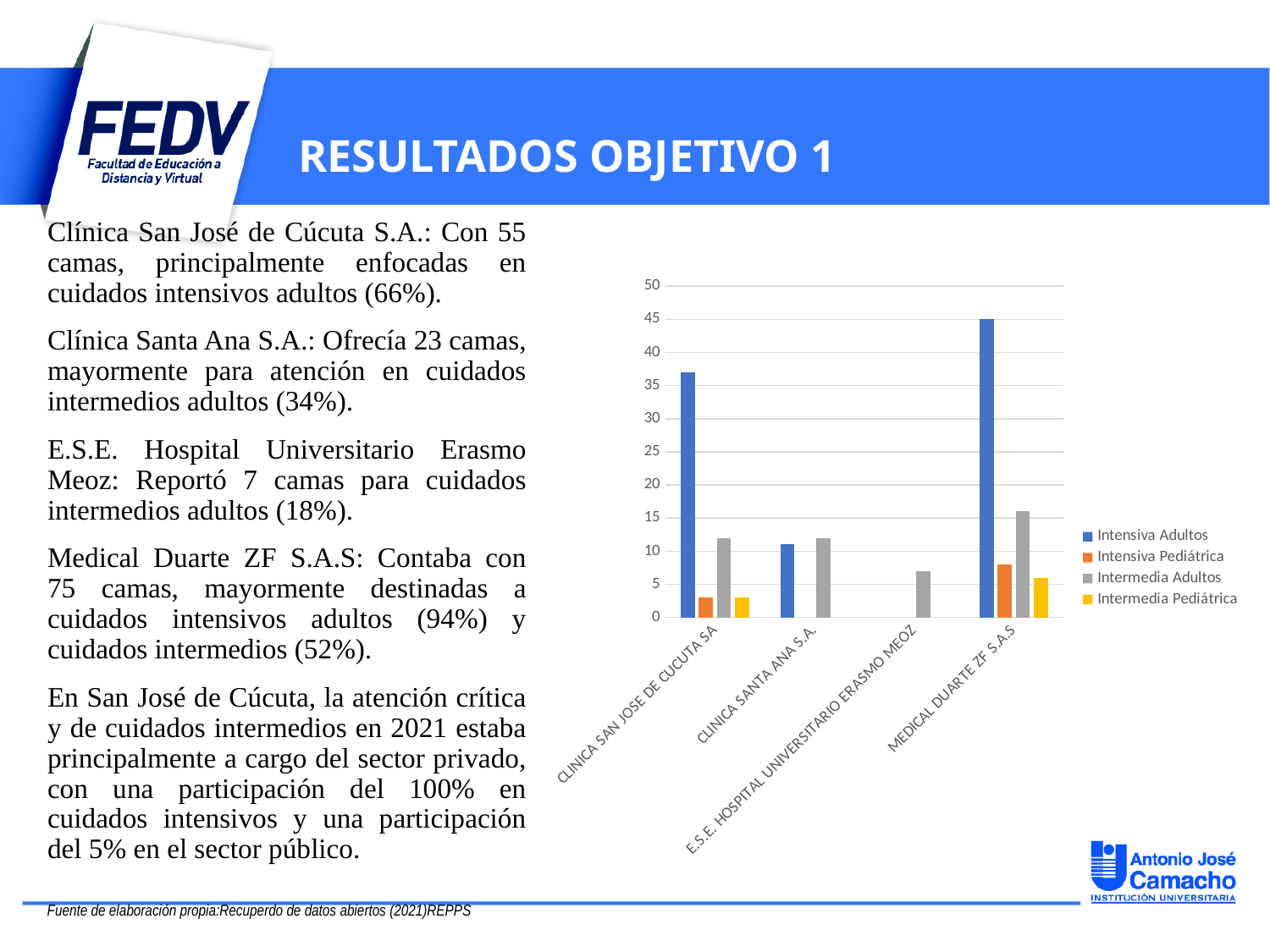
How many institutions (categories) are shown on the x axis of the chart? 4 How many series does the chart legend list? 4 What is the Intensiva Adultos value for MEDICAL DUARTE ZF S.A.S in the chart? 45 What kind of chart is shown on the slide? bar chart Is the Intensiva Adultos value for CLINICA SAN JOSE DE CUCUTA SA greater or less than 30? greater What colour represents the Intermedia Pediátrica series in the chart legend? yellow Which institution in the chart has a bar for only one series (Intermedia Adultos)? E.S.E. HOSPITAL UNIVERSITARIO ERASMO MEOZ Is the Intermedia Adultos value for MEDICAL DUARTE ZF S.A.S greater or less than 10? greater Is the Intensiva Adultos value for CLINICA SANTA ANA S.A. greater or less than 15? less Which is larger: the Intensiva Adultos value for MEDICAL DUARTE ZF S.A.S or for CLINICA SAN JOSE DE CUCUTA SA? MEDICAL DUARTE ZF S.A.S Which institution has the highest Intensiva Adultos value in the chart? MEDICAL DUARTE ZF S.A.S